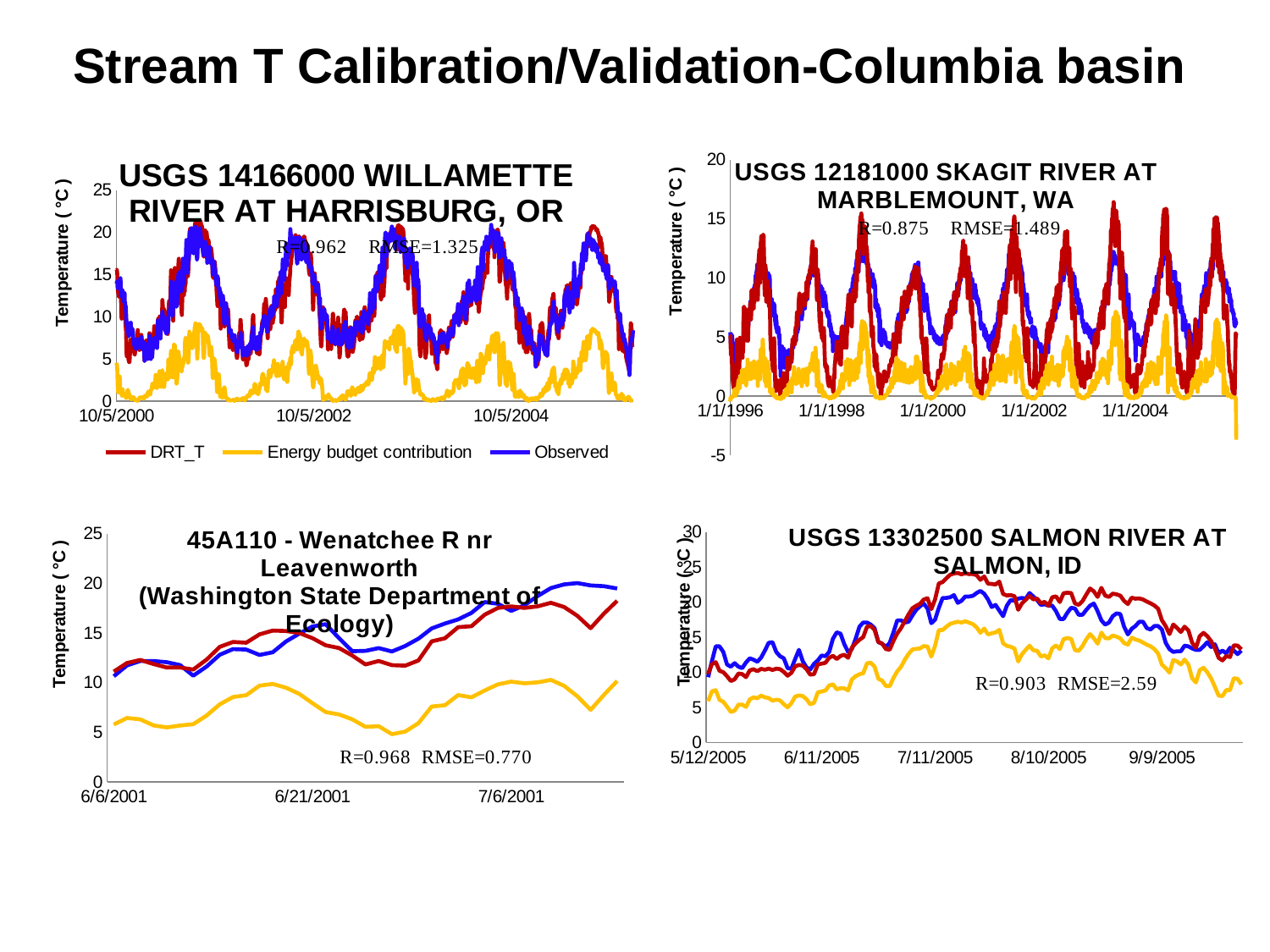
In the WILLAMETTE RIVER AT HARRISBURG chart, are the summer peaks of the Observed series greater or less than 15? greater What kind of chart is the USGS 14166000 WILLAMETTE RIVER AT HARRISBURG, OR chart? line chart In the WILLAMETTE RIVER AT HARRISBURG chart, which series is plotted in yellow? Energy budget contribution In the SKAGIT RIVER AT MARBLEMOUNT, WA chart, is the Energy budget contribution (yellow) line greater or less than 10 throughout? less What R value is printed on the SKAGIT RIVER AT MARBLEMOUNT, WA chart? R=0.875 How many series does the legend under the WILLAMETTE RIVER AT HARRISBURG chart list? 3 In the 45A110 - Wenatchee R nr Leavenworth chart, does the Observed (blue) line rise or fall from 6/6/2001 to the end of the period? rise In the SKAGIT RIVER AT MARBLEMOUNT, WA chart, which is higher at the seasonal peaks, the DRT_T (red) line or the Observed (blue) line? DRT_T In the WILLAMETTE RIVER AT HARRISBURG chart, which series stays lowest across the whole period? Energy budget contribution In the 45A110 - Wenatchee R nr Leavenworth chart, is the Energy budget contribution (yellow) line greater or less than 15 throughout? less How many charts are shown on the slide? 4